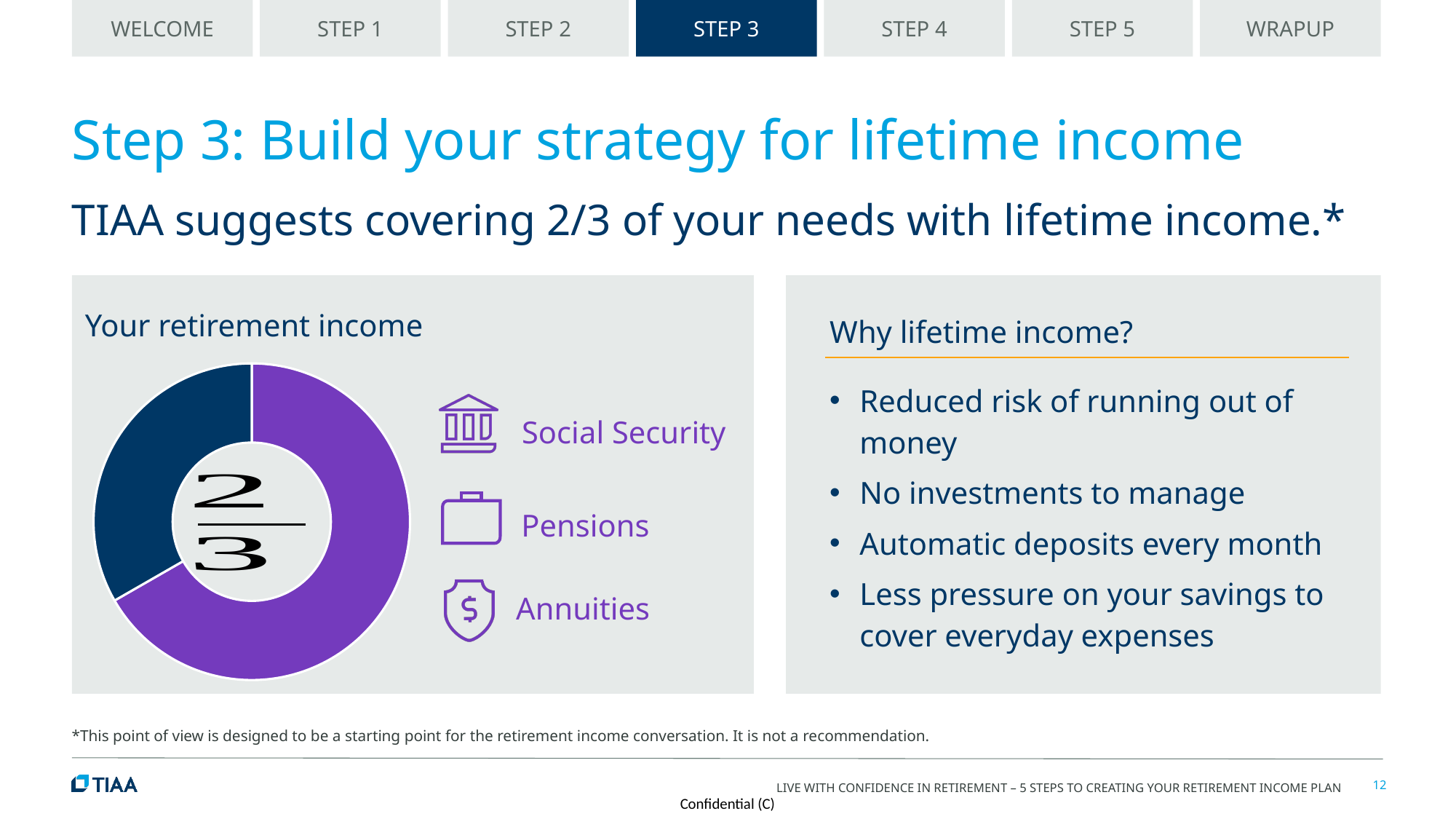
What fraction is printed in the centre of the donut chart? 2/3 What kind of chart is shown under "Your retirement income"? Pie chart (donut) What three income sources are listed next to the donut chart? Social Security, Pensions, Annuities Is the purple slice of the donut chart greater or less than half of the chart? greater Which slice of the "Your retirement income" chart is the largest? The purple slice How many slices does the "Your retirement income" chart have? 2 What is the title of the chart on the left of the slide? Your retirement income Which slice of the "Your retirement income" chart is the smallest? The dark blue slice Which slice of the "Your retirement income" chart is larger, the purple one or the dark blue one? The purple one What share of the "Your retirement income" chart does the purple slice represent? 2/3